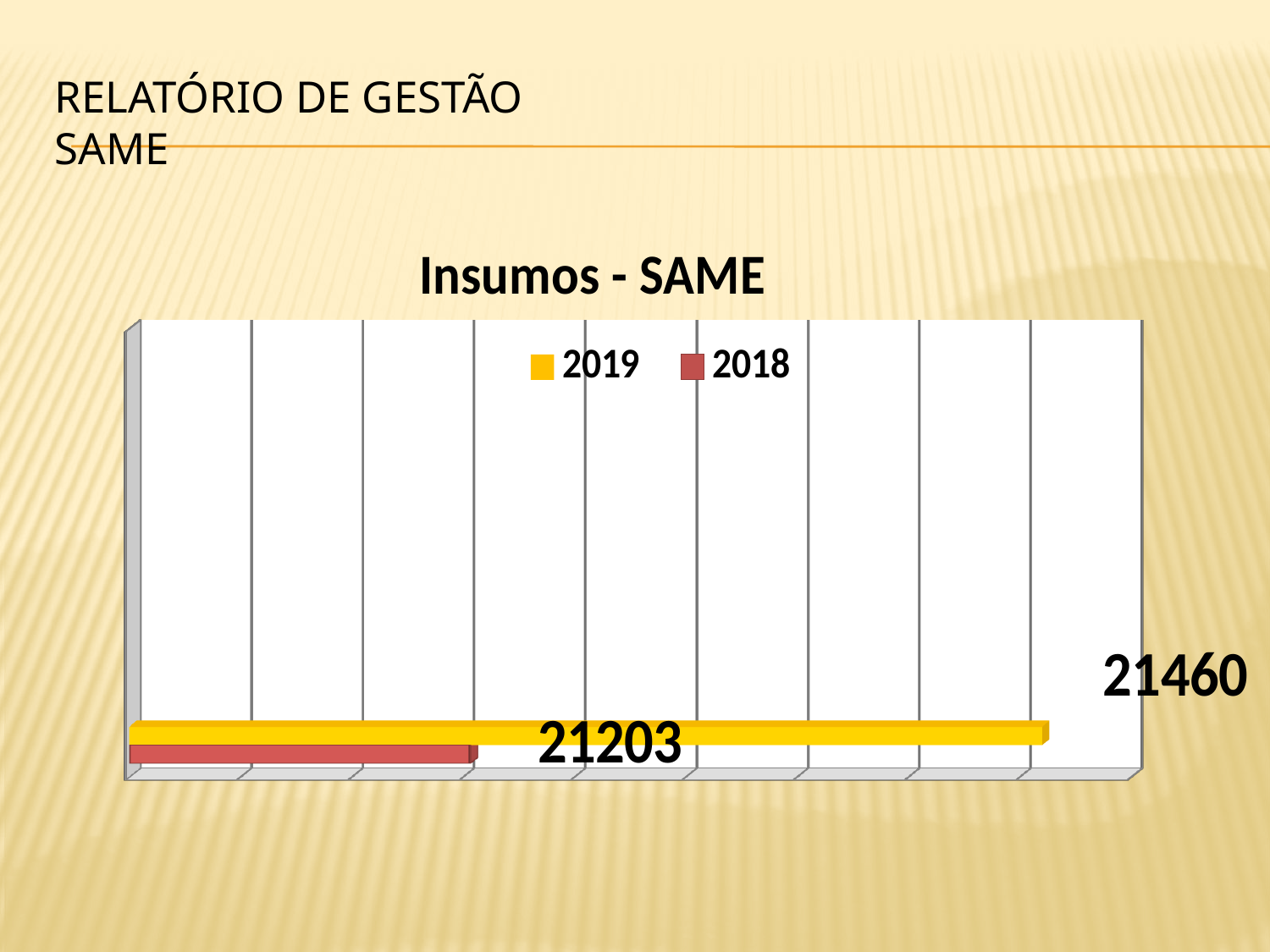
Which series has the higher value in the Insumos - SAME chart, 2019 or 2018? 2019 What is the difference between the 2019 and 2018 values in the Insumos - SAME chart? 257 What is the value for 2019 in the Insumos - SAME chart? 21460 Which series has the highest value in the Insumos - SAME chart? 2019 How many bars are plotted in the Insumos - SAME chart? 2 Which colour represents the 2018 series in the Insumos - SAME chart? Red What is the title of the chart on the slide? Insumos - SAME Which series has the lowest value in the Insumos - SAME chart? 2018 How many series does the legend of the Insumos - SAME chart list? 2 What is the value for 2018 in the Insumos - SAME chart? 21203 What kind of chart is the Insumos - SAME chart? Bar chart